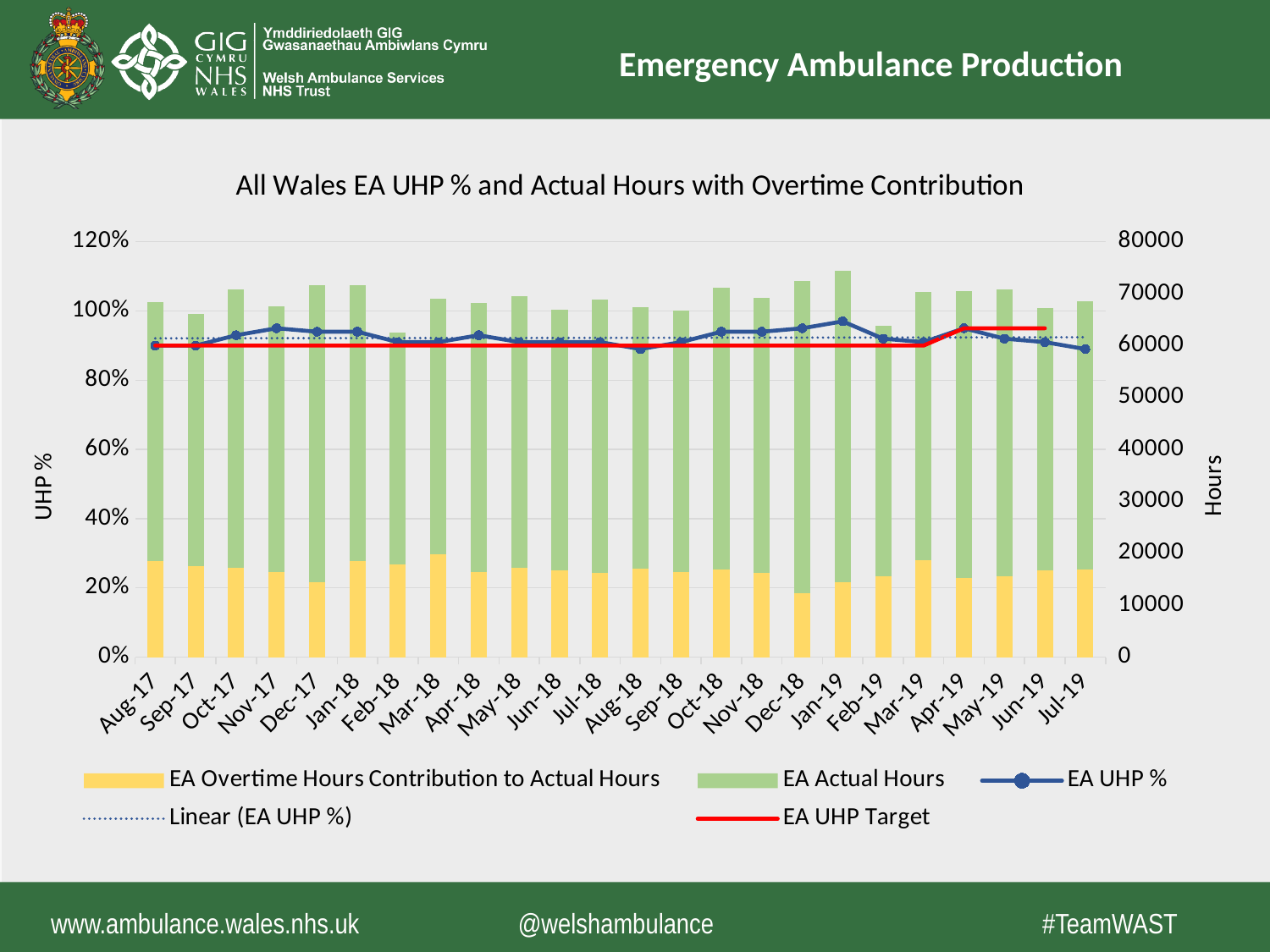
What kind of chart is this? Combined bar and line chart Which is larger, the EA Overtime Hours Contribution in Mar-18 or in Dec-18? Mar-18 What is the title of the chart? All Wales EA UHP % and Actual Hours with Overtime Contribution Is the EA Overtime Hours Contribution for Dec-18 greater or less than 15000? less What is the label on the right-hand vertical axis? Hours How many months are shown on the x axis? 24 Which month has the tallest stacked bar for total hours? Jan-19 How many series does the legend list? 5 Is the total hours bar for Feb-18 greater or less than 70000? less In which month does the EA UHP % line reach its highest point? Jan-19 Is the total hours bar for Jan-19 greater or less than 70000? greater